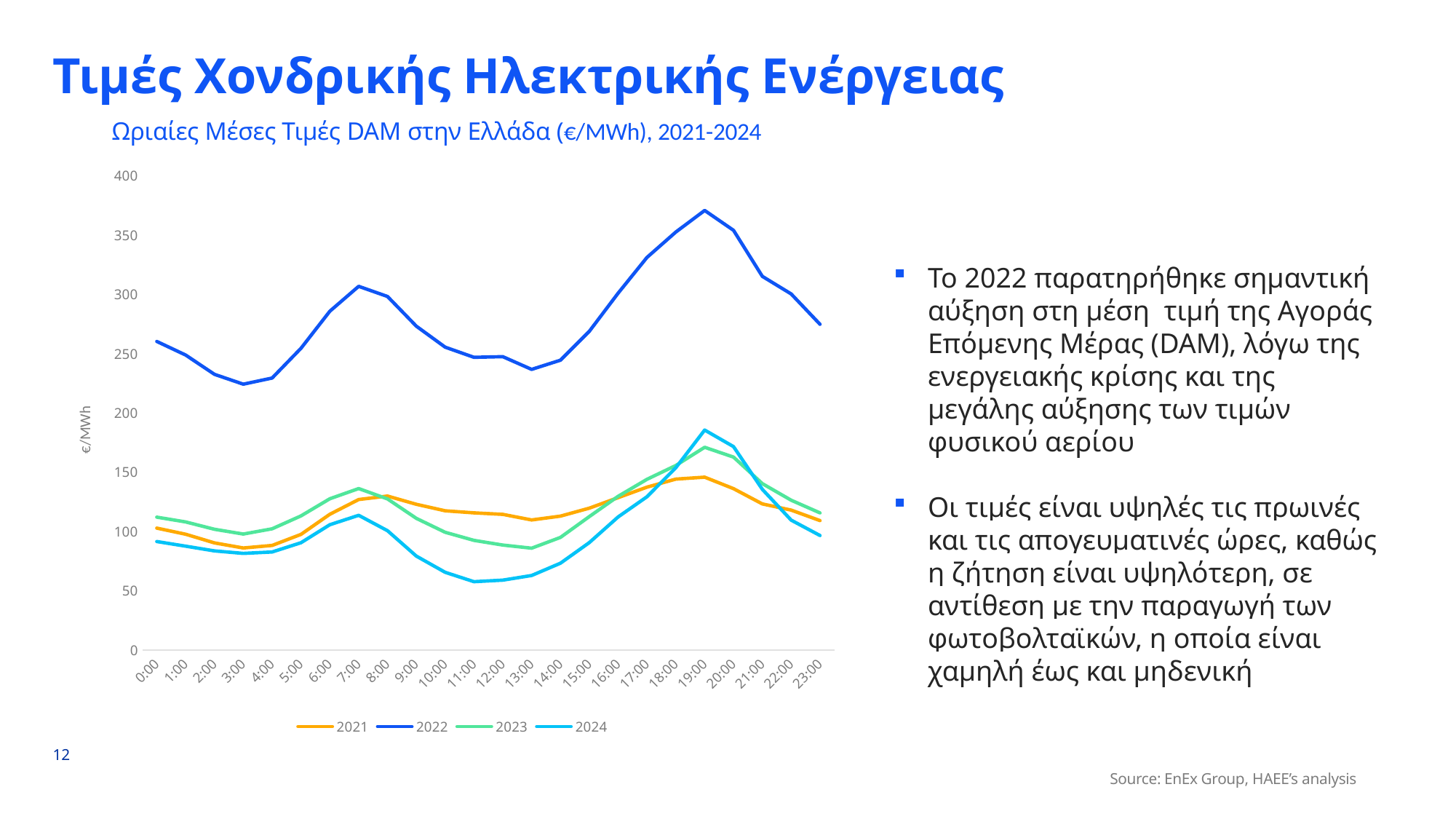
How many hourly points are shown along the x axis? 24 At 19:00, which series is larger, 2022 or 2021? 2022 How many series does the legend list? 4 Is the value for 2023 at 7:00 greater or less than 100? greater Which series has the lowest value at 11:00? 2024 Which series has the highest values across the day? 2022 Is the value for 2024 at 11:00 greater or less than 100? less What kind of chart is shown on the slide? line chart Is the value for 2022 at 19:00 greater or less than 350? greater What unit is shown on the y axis label? €/MWh Do the values for 2022 rise or fall from 19:00 to 23:00? fall